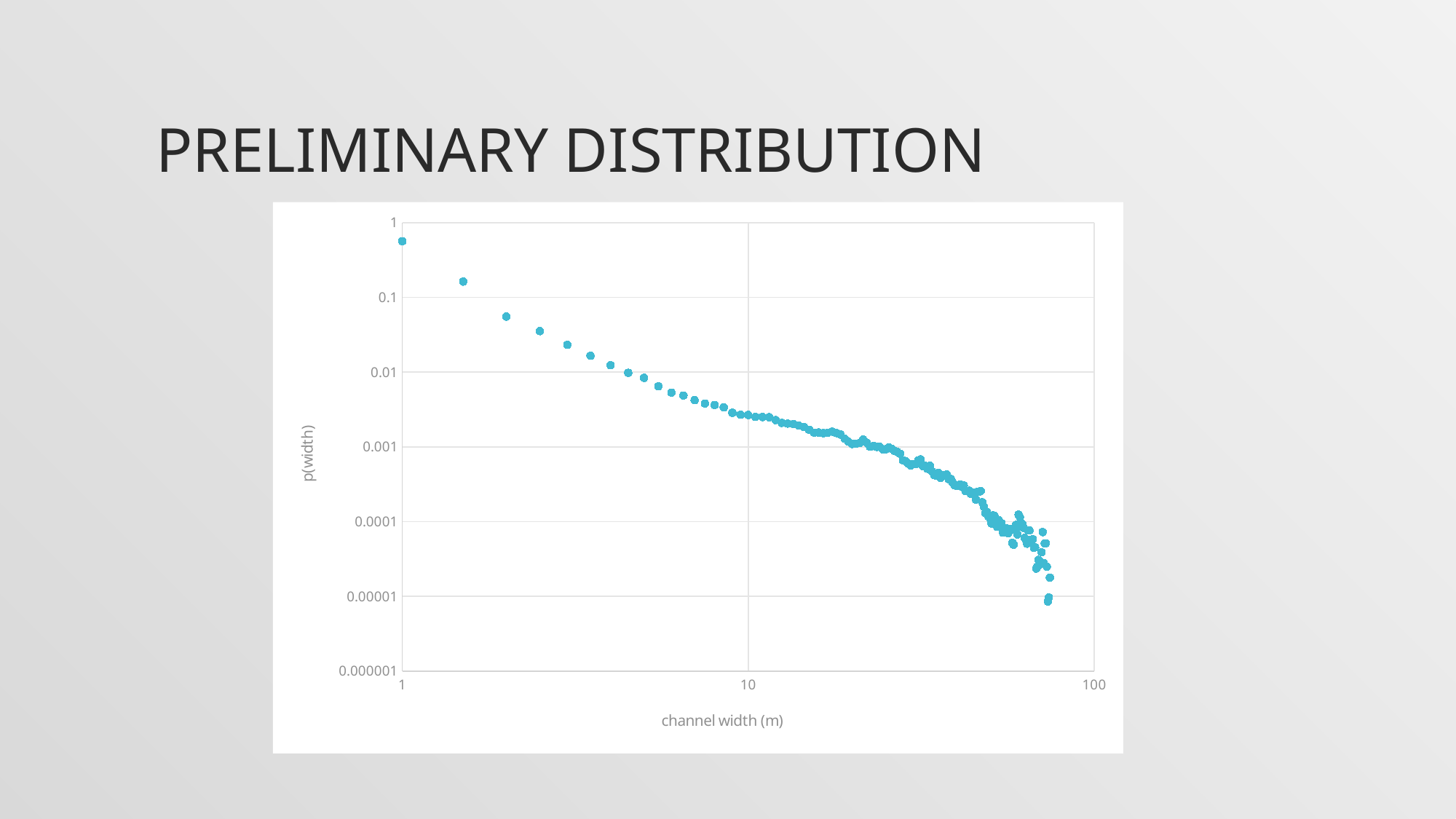
Is the p(width) value at a channel width of 10 m greater or less than 0.001? greater Is the p(width) value at a channel width of 10 m greater or less than 0.01? less At which channel width on the x axis does the highest p(width) value occur? 1 Is the lowest plotted p(width) value greater or less than 0.000001? greater What is the label of the x axis? channel width (m) What is the label of the y axis? p(width) What kind of chart is shown on the slide? scatter plot Do the p(width) values rise or fall as channel width increases along the x axis? fall